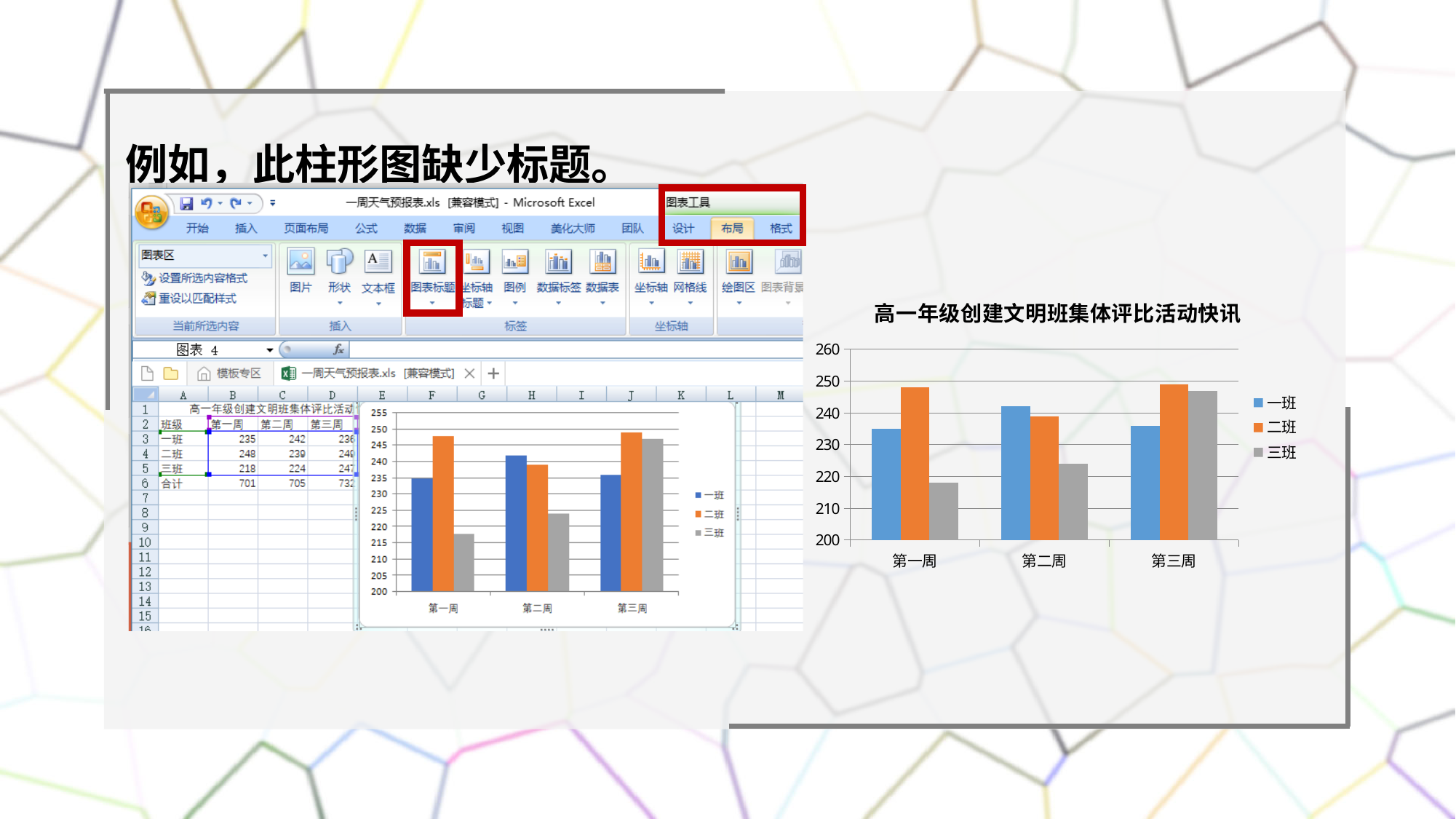
In the chart on the right, is the value for 二班 in 第一周 greater or less than 240? greater How many series does the legend of the chart on the right list? 3 In the chart on the right, is the value for 三班 in 第三周 greater or less than 240? greater In the chart on the right, which is larger for 三班: the bar for 第一周 or the bar for 第三周? 第三周 In the chart on the right, which series has the highest bar for 第一周? 二班 In the chart on the right, is the value for 三班 in 第一周 greater or less than 220? less How many categories are shown on the x axis of the chart on the right? 3 In the chart on the right, do the bars for 三班 rise or fall from 第一周 to 第三周? rise In the chart on the right, which series has the lowest bar for 第三周? 一班 In the chart on the right, which series has the lowest bar for 第一周? 三班 What kind of chart is the chart on the right side of the slide? bar chart What is the title of the chart on the right side of the slide? 高一年级创建文明班集体评比活动快讯